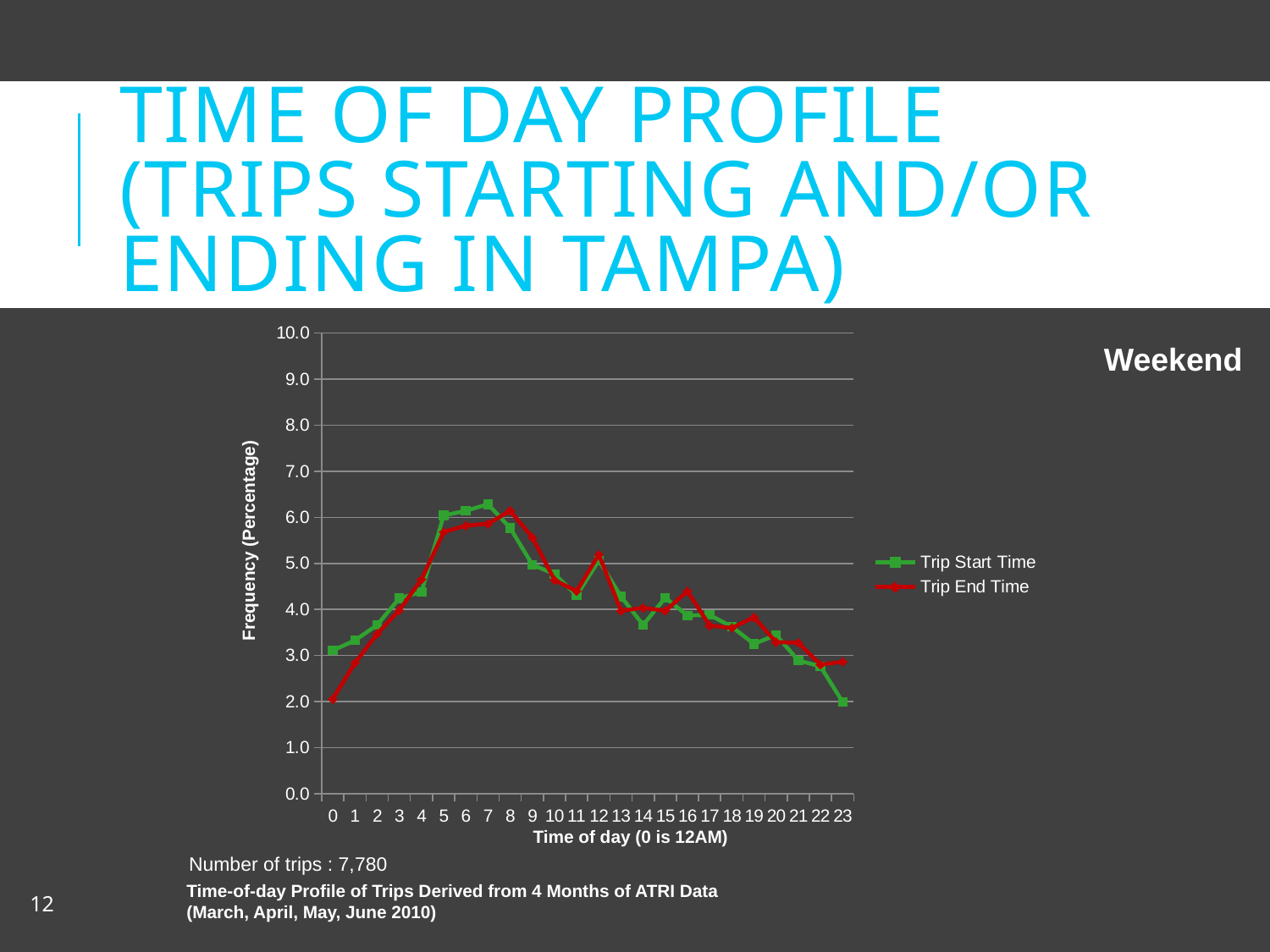
Does the Trip Start Time series generally rise or fall from hour 8 to hour 23? Fall How many time-of-day points are plotted along the x axis? 24 Is the Trip End Time value at hour 0 greater or less than 3.0? less At which hour does the Trip End Time series reach its highest value? 8 What is the title of the chart's y axis? Frequency (Percentage) Is the Trip Start Time value at hour 7 greater or less than 6.0? greater At hour 0, which series has the higher value, Trip Start Time or Trip End Time? Trip Start Time What type of chart is shown on the slide? Line chart How many series does the chart's legend list? 2 At which hour is the Trip End Time series at its lowest value? 0 At which hour is the Trip Start Time series at its lowest value? 23 At which hour does the Trip Start Time series reach its highest value? 7